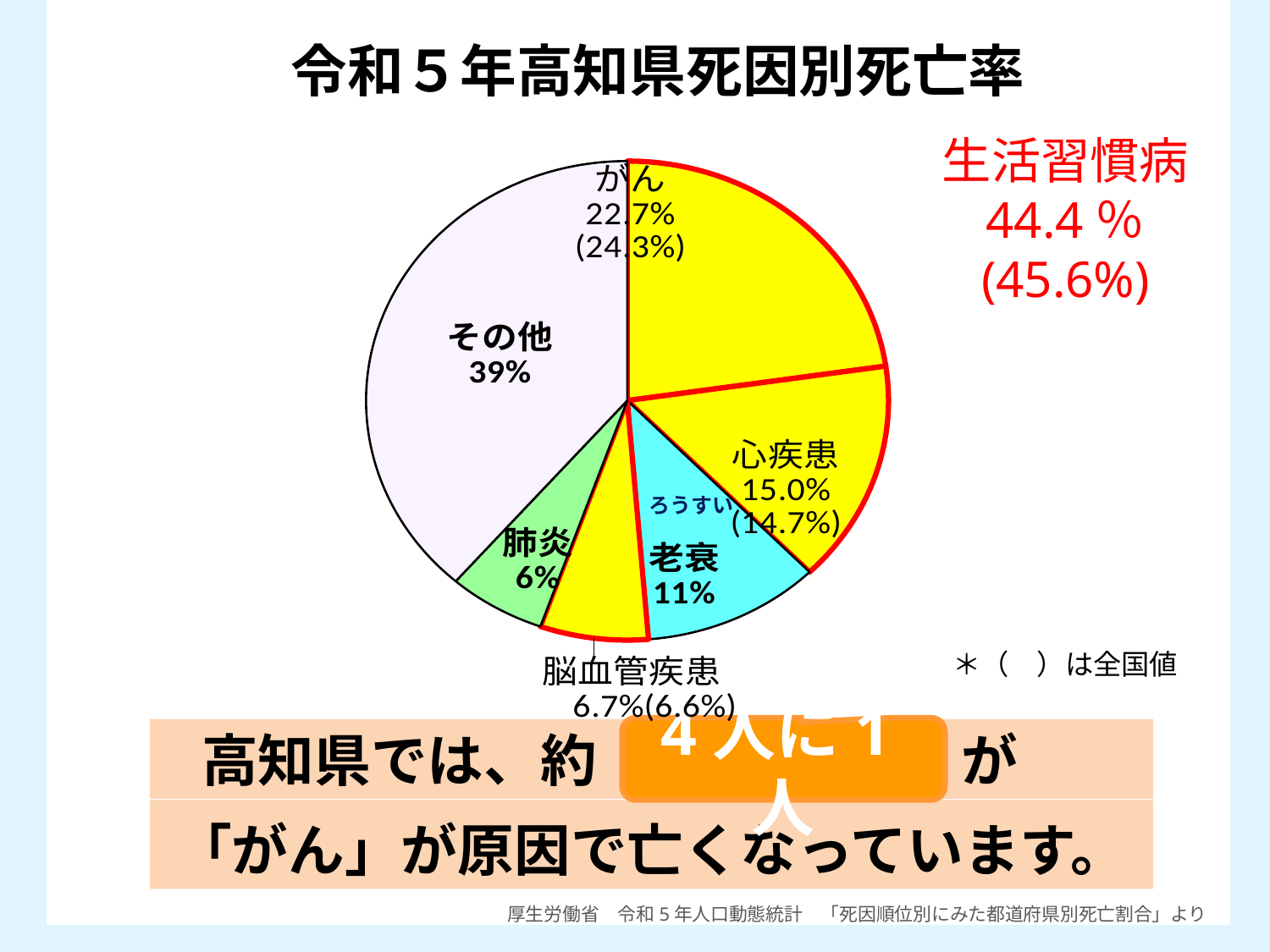
What percentage is shown for がん (cancer) in Kochi Prefecture? 22.7% What percentage is shown for 老衰? 11% Which slice of the pie chart is the smallest? 肺炎 What kind of chart is shown on the slide? pie chart What percentage is shown for 心疾患 (heart disease) in Kochi Prefecture? 15.0% What percentage is shown for その他? 39% What is the title of the chart? 令和５年高知県死因別死亡率 What percentage is shown for 脳血管疾患 in Kochi Prefecture? 6.7% What percentage is shown for 肺炎? 6% Which slice of the pie chart is the largest? その他 How many slices does the pie chart have? 6 What is the difference between the Kochi percentages for がん and 心疾患? 7.7%